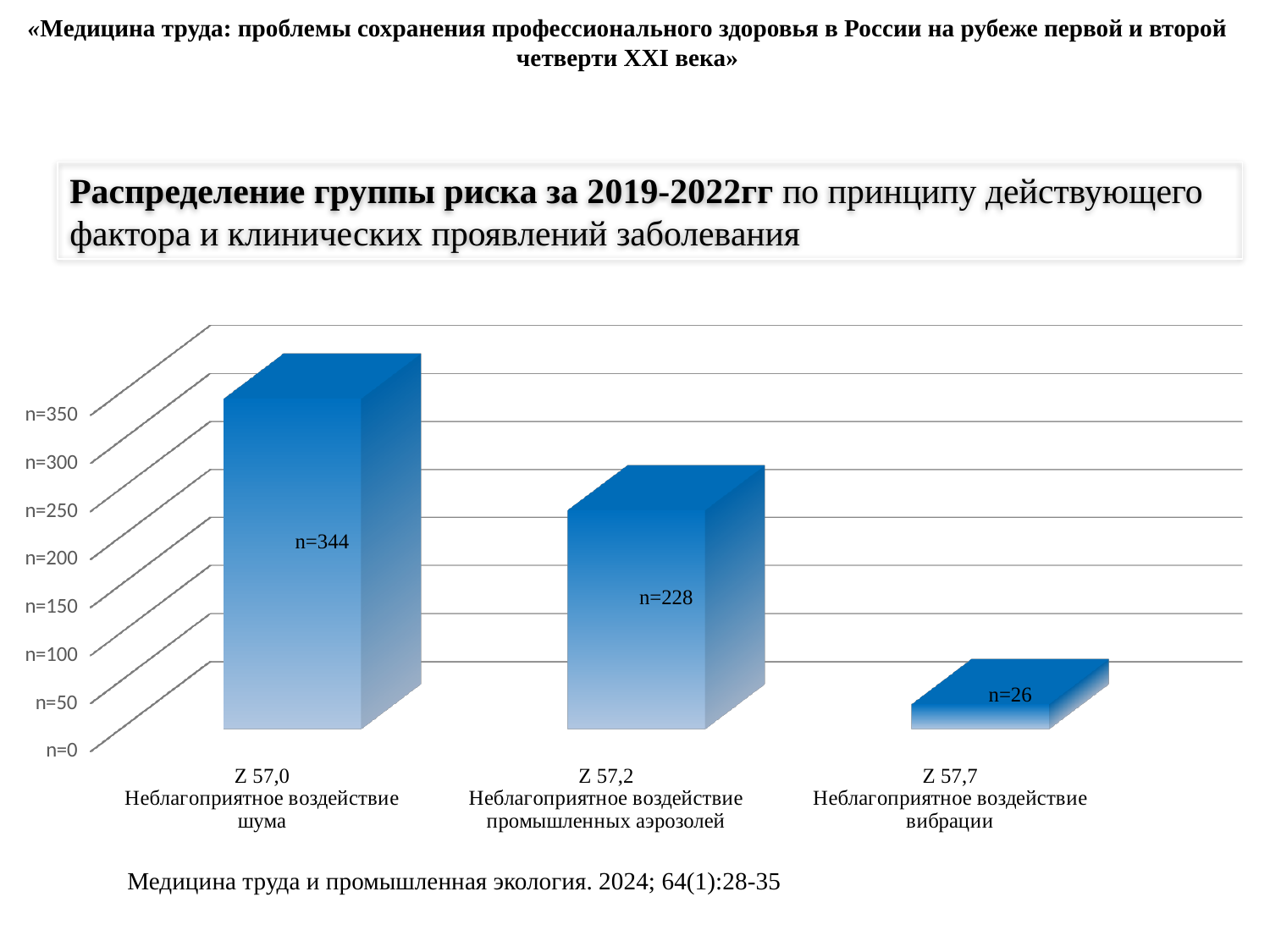
How many categories are shown in the chart? 3 Which category has the lowest value? Z 57,7 Неблагоприятное воздействие вибрации What is the value for Z 57,0 Неблагоприятное воздействие шума? n=344 What is the value for Z 57,2 Неблагоприятное воздействие промышленных аэрозолей? n=228 Do the values rise or fall from left to right across the categories? Fall Which category has the highest value? Z 57,0 Неблагоприятное воздействие шума What is the value for Z 57,7 Неблагоприятное воздействие вибрации? n=26 What is the difference between the values for Z 57,2 (промышленных аэрозолей) and Z 57,7 (вибрации)? 202 What is the difference between the values for Z 57,0 (шума) and Z 57,2 (промышленных аэрозолей)? 116 Which is larger, the value for Z 57,2 (промышленных аэрозолей) or Z 57,7 (вибрации)? Z 57,2 Неблагоприятное воздействие промышленных аэрозолей What kind of chart is shown on the slide? Bar chart What is the total of the three values shown in the chart? 598